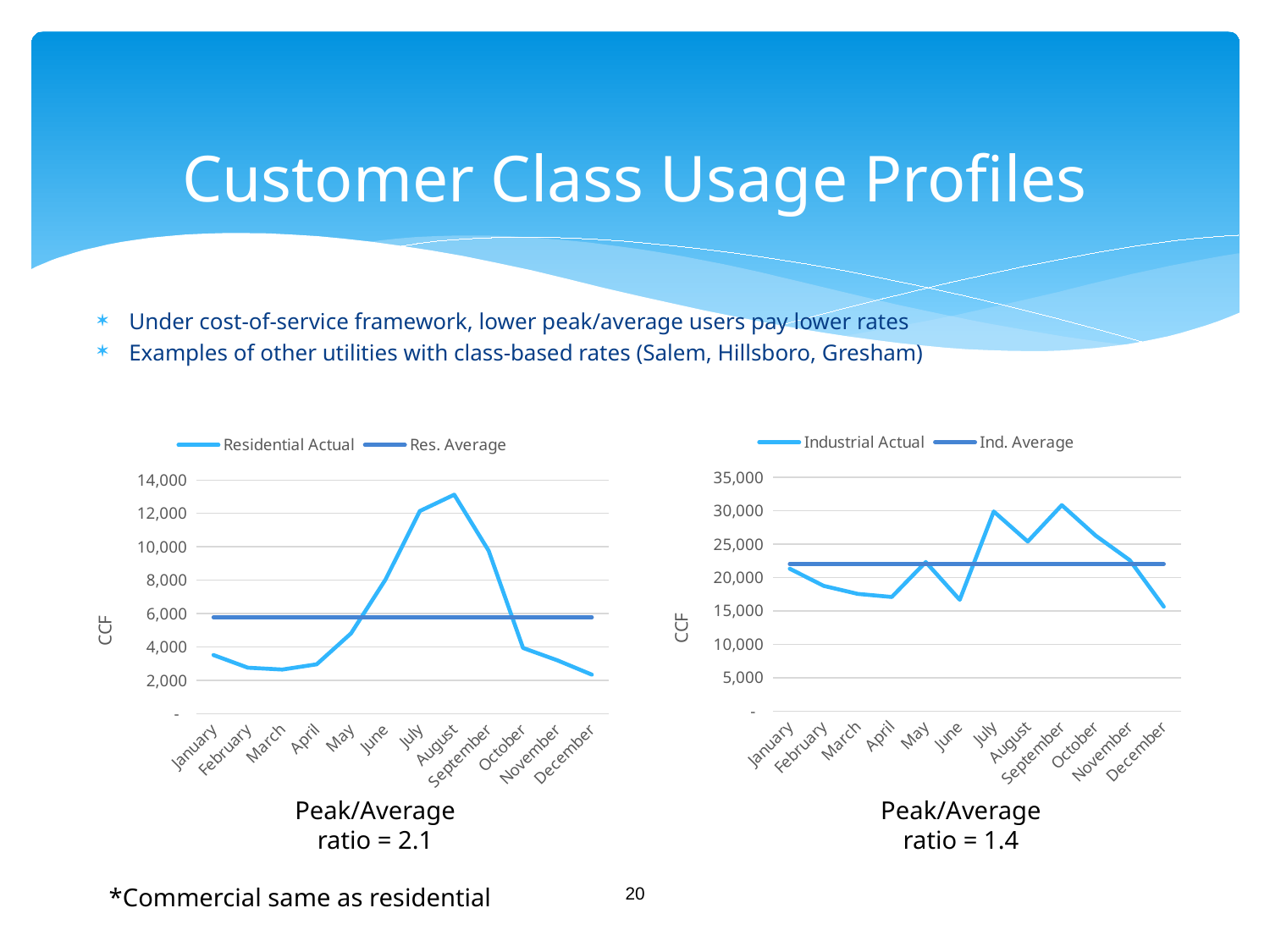
What kind of chart is the left chart (Residential Actual / Res. Average)? line chart In the left chart (Residential Actual / Res. Average), which month has the highest Residential Actual value? August How many series does the legend of the right chart (Industrial Actual / Ind. Average) list? 2 In the right chart (Industrial Actual / Ind. Average), is the Industrial Actual value for July greater or less than 25,000? greater What is the y-axis label of the right chart (Industrial Actual / Ind. Average)? CCF In the left chart (Residential Actual / Res. Average), does the Residential Actual line rise or fall from August to December? fall In the left chart (Residential Actual / Res. Average), which is larger, the Residential Actual value for July or for January? July How many months are plotted along the x axis of the left chart (Residential Actual / Res. Average)? 12 In the left chart (Residential Actual / Res. Average), is the Residential Actual value for August greater or less than 12,000? greater In the right chart (Industrial Actual / Ind. Average), which is larger, the Industrial Actual value for July or for January? July In the left chart (Residential Actual / Res. Average), is the Residential Actual value for January greater or less than 4,000? less